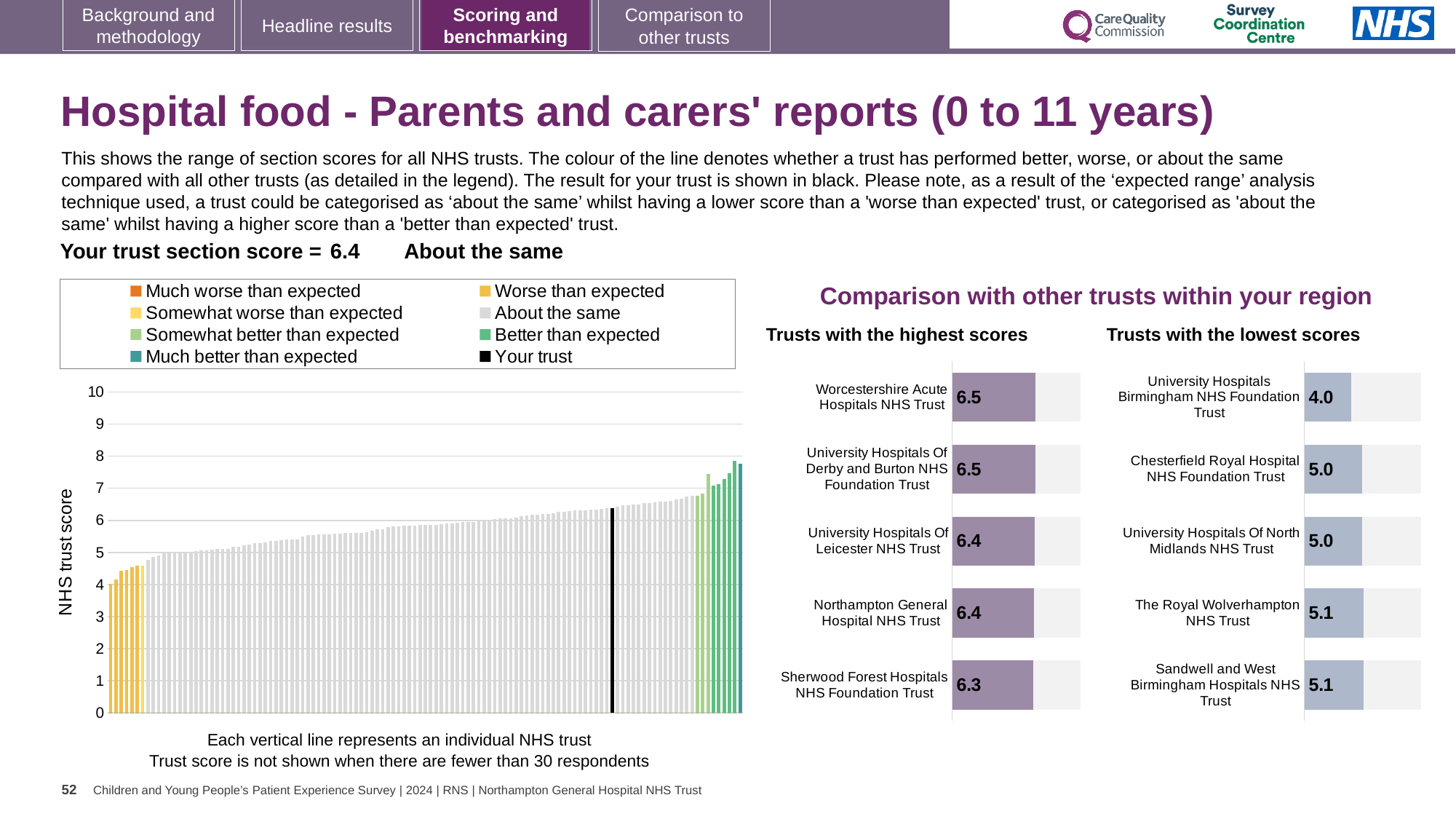
In the 'Trusts with the highest scores' chart, what is the score for Worcestershire Acute Hospitals NHS Trust? 6.5 In the 'Trusts with the lowest scores' chart, what is the score for University Hospitals Birmingham NHS Foundation Trust? 4.0 In the 'Trusts with the lowest scores' chart, what is the difference between the scores of Sandwell and West Birmingham Hospitals NHS Trust and University Hospitals Birmingham NHS Foundation Trust? 1.1 In the 'Trusts with the lowest scores' chart, which trust has the lowest score? University Hospitals Birmingham NHS Foundation Trust In the 'Trusts with the lowest scores' chart, how many trusts are shown? 5 In the main 'NHS trust score' chart on the left, is the value of the lowest bar greater or less than 5? less In the main 'NHS trust score' chart on the left, do the bar values rise or fall from left to right? rise What kind of chart is the 'Trusts with the highest scores' chart? bar chart In the 'Trusts with the highest scores' chart, which has the larger score: Worcestershire Acute Hospitals NHS Trust or Sherwood Forest Hospitals NHS Foundation Trust? Worcestershire Acute Hospitals NHS Trust In the 'Trusts with the highest scores' chart, which trust has the lowest score? Sherwood Forest Hospitals NHS Foundation Trust In the 'Trusts with the highest scores' chart, what is the score for Sherwood Forest Hospitals NHS Foundation Trust? 6.3 How many entries does the legend of the main 'NHS trust score' chart list? 8